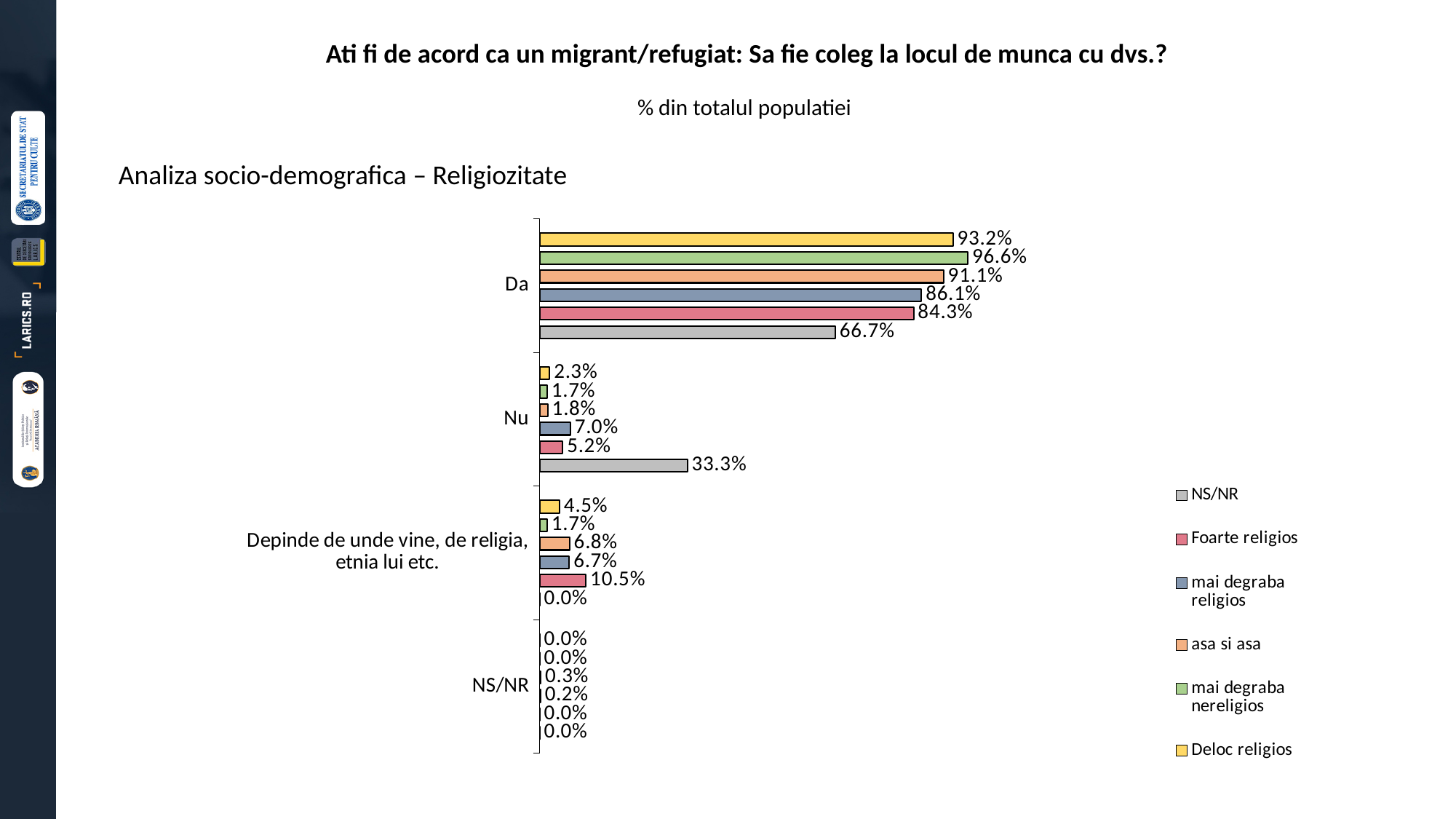
Which series has the lowest value in the 'Da' category? NS/NR What is the value for 'mai degraba nereligios' in the 'Da' category? 96.6% What is the difference between 'Deloc religios' and 'Foarte religios' in the 'Da' category? 8.9% How many series does the legend list? 6 What kind of chart is shown on the slide? bar chart What is the subtitle shown under the chart title? % din totalul populatiei In the 'Nu' category, which is larger: 'Foarte religios' or 'mai degraba religios'? mai degraba religios How many response categories are shown on the vertical axis? 4 Which series has the highest value in the 'Da' category? mai degraba nereligios What is the value for 'Foarte religios' in the 'Depinde de unde vine, de religia, etnia lui etc.' category? 10.5% What is the value for 'mai degraba religios' in the 'Nu' category? 7.0% What is the value for 'NS/NR' in the 'Nu' category? 33.3%